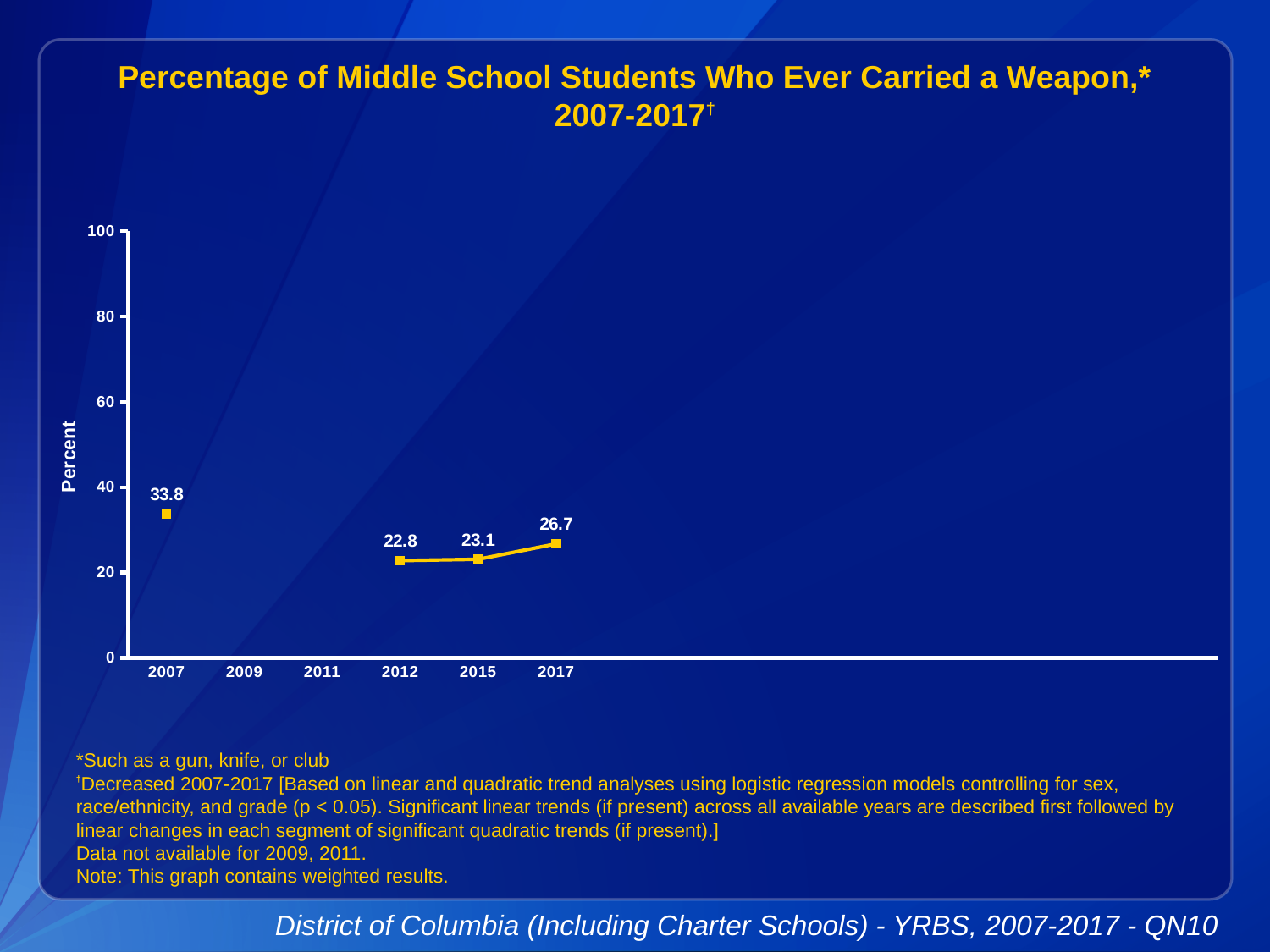
Is the value for 2007 greater or less than 40? less What is the difference between the 2007 value and the 2017 value? 7.1 What is the value plotted for 2017? 26.7 Which year has the highest percentage of students who ever carried a weapon? 2007 What is the label on the y axis? Percent What kind of chart is shown on the slide? line chart What is the percentage of middle school students who ever carried a weapon in 2007? 33.8 What is the value plotted for 2012? 22.8 What is the value plotted for 2015? 23.1 Which year has the lowest percentage of students who ever carried a weapon? 2012 How many years have data points plotted on the chart? 4 Which year has a larger value, 2012 or 2017? 2017